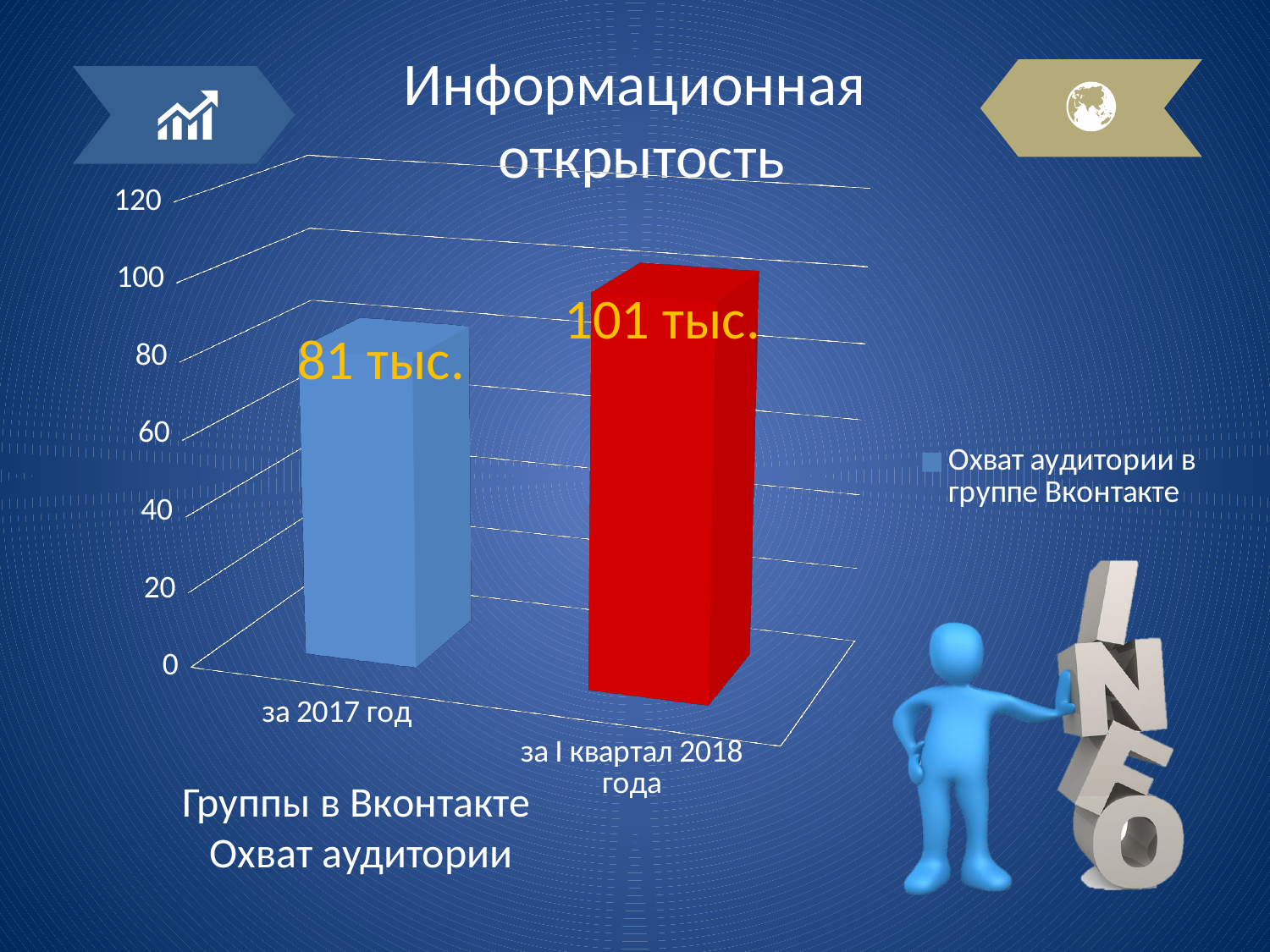
Which category has the lowest value? за 2017 год What kind of chart is shown on the slide? bar chart Is the value for "за 2017 год" greater or less than 100? less How many series does the legend list? 1 Which category has the highest value? за I квартал 2018 года Is the value for "за I квартал 2018 года" greater or less than 100? greater How many categories are shown on the chart? 2 What is the value for "за I квартал 2018 года"? 101 тыс. What is the difference between the value for "за I квартал 2018 года" and the value for "за 2017 год"? 20 тыс. Which is larger: the value for "за 2017 год" or the value for "за I квартал 2018 года"? за I квартал 2018 года What is the value for "за 2017 год"? 81 тыс. What is the legend entry of the chart? Охват аудитории в группе Вконтакте